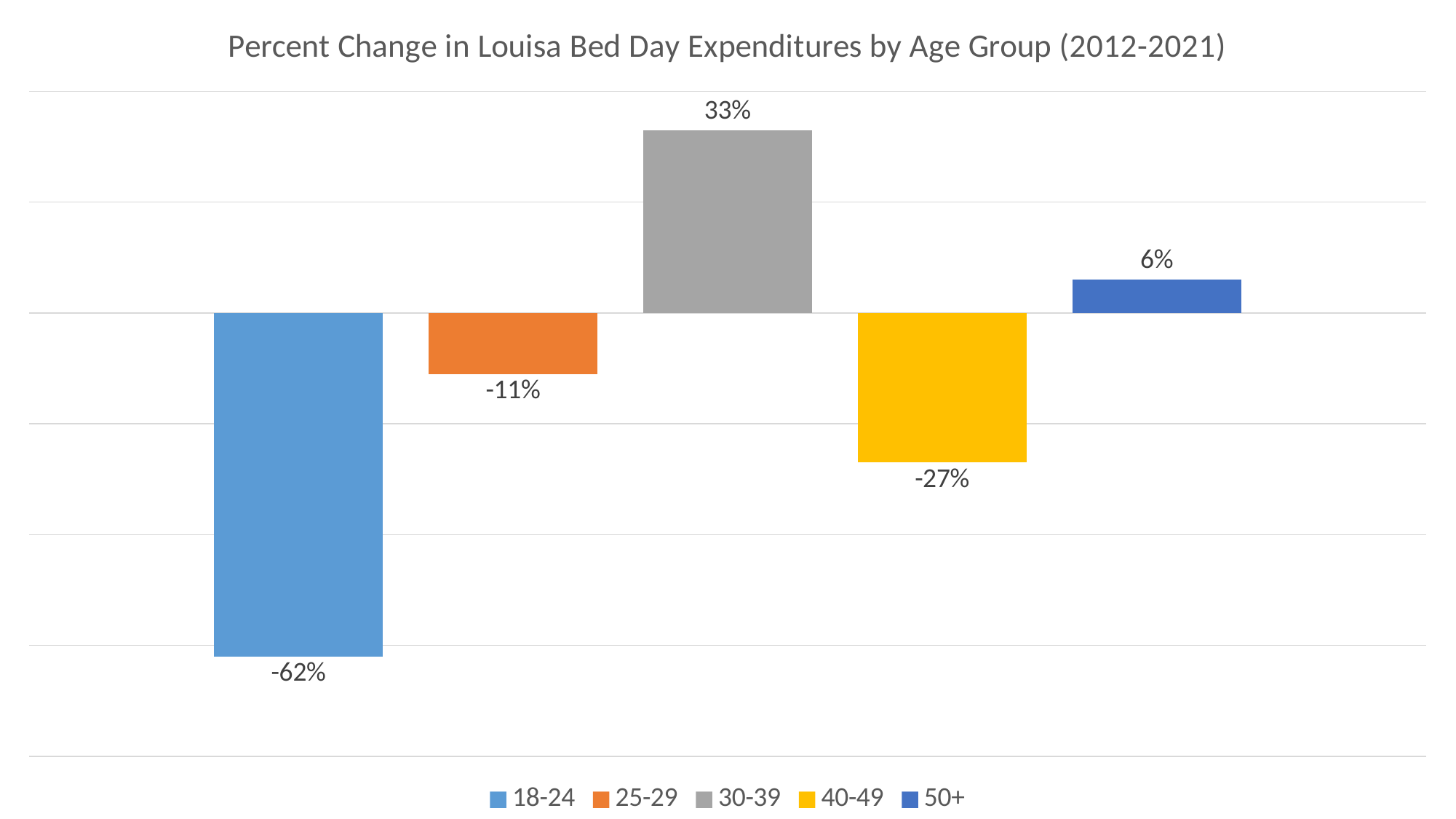
Which age group has a larger percent change, 25-29 or 40-49? 25-29 What type of chart is shown on the slide? Bar chart Which age group has the lowest percent change in bed day expenditures? 18-24 What is the percent change in bed day expenditures for the 50+ age group? 6% What is the percent change in bed day expenditures for the 30-39 age group? 33% How many entries does the legend list? 5 Which age group has the highest percent change in bed day expenditures? 30-39 How many age groups are shown in the chart? 5 What is the title of the chart? Percent Change in Louisa Bed Day Expenditures by Age Group (2012-2021) What is the percent change in bed day expenditures for the 18-24 age group? -62% What is the difference between the percent change for the 30-39 age group and the 50+ age group? 27 percentage points What is the percent change in bed day expenditures for the 40-49 age group? -27%